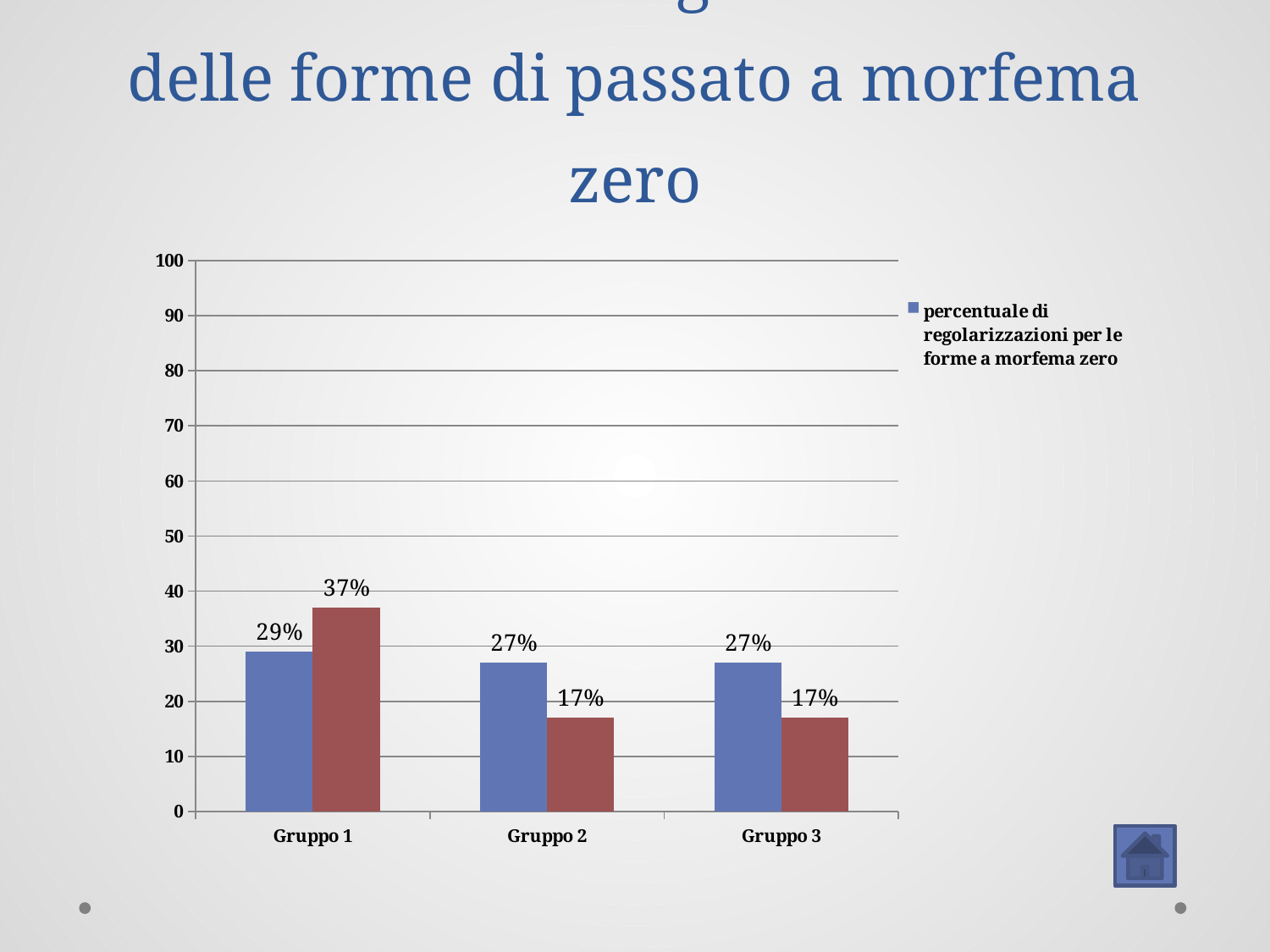
How many groups (categories) are shown on the x axis? 3 What kind of chart is shown on the slide? bar chart What is the difference between the blue bar and the red bar for Gruppo 2? 10% What is the value of the red bar for Gruppo 1? 37% What is the difference between the red bar and the blue bar for Gruppo 1? 8% What is the value of the red bar for Gruppo 3? 17% What is the value of the blue bar for Gruppo 2? 27% What is the legend entry shown for the blue series? percentuale di regolarizzazioni per le forme a morfema zero For Gruppo 3, which is larger, the blue bar or the red bar? the blue bar What is the value of the blue bar (percentuale di regolarizzazioni per le forme a morfema zero) for Gruppo 1? 29% Which group has the highest red bar? Gruppo 1 Which group has the highest blue bar? Gruppo 1